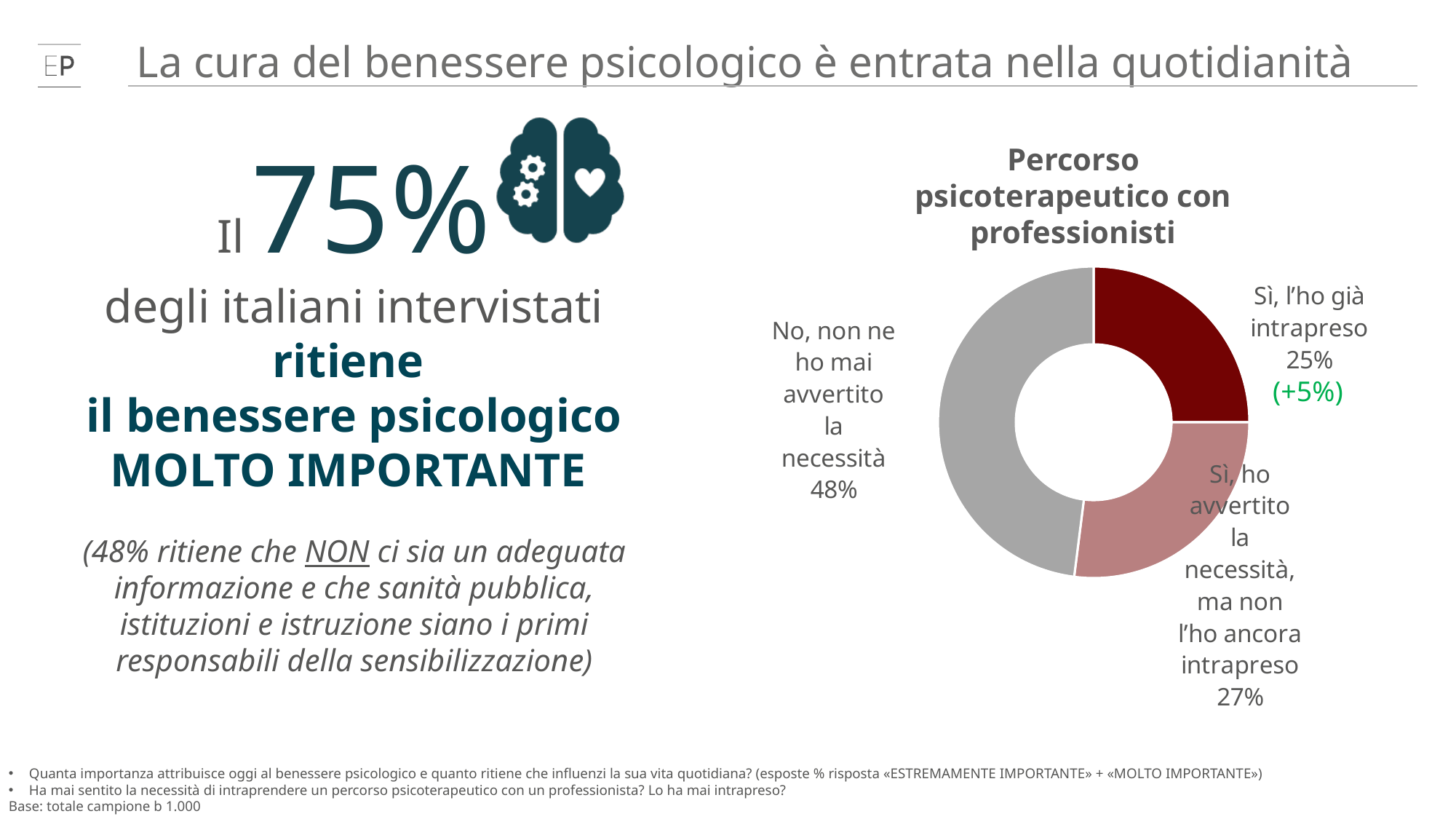
What is the combined share of the two 'Sì' responses in the doughnut chart? 52% Which response has the largest share in the doughnut chart? No, non ne ho mai avvertito la necessità Which response has the smallest share in the doughnut chart? Sì, l'ho già intrapreso Which is larger: the share for 'Sì, ho avvertito la necessità, ma non l'ho ancora intrapreso' or for 'Sì, l'ho già intrapreso'? Sì, ho avvertito la necessità, ma non l'ho ancora intrapreso How many categories does the doughnut chart show? 3 What percentage of respondents answered 'Sì, ho avvertito la necessità, ma non l'ho ancora intrapreso'? 27% What is the difference in percentage points between 'No, non ne ho mai avvertito la necessità' and 'Sì, l'ho già intrapreso'? 23 What is the title of the doughnut chart? Percorso psicoterapeutico con professionisti What change is indicated in green next to the 'Sì, l'ho già intrapreso' slice? +5% What type of chart is shown under the title 'Percorso psicoterapeutico con professionisti'? Doughnut chart What percentage of respondents answered 'No, non ne ho mai avvertito la necessità'? 48% What percentage of respondents answered 'Sì, l'ho già intrapreso' in the doughnut chart? 25%